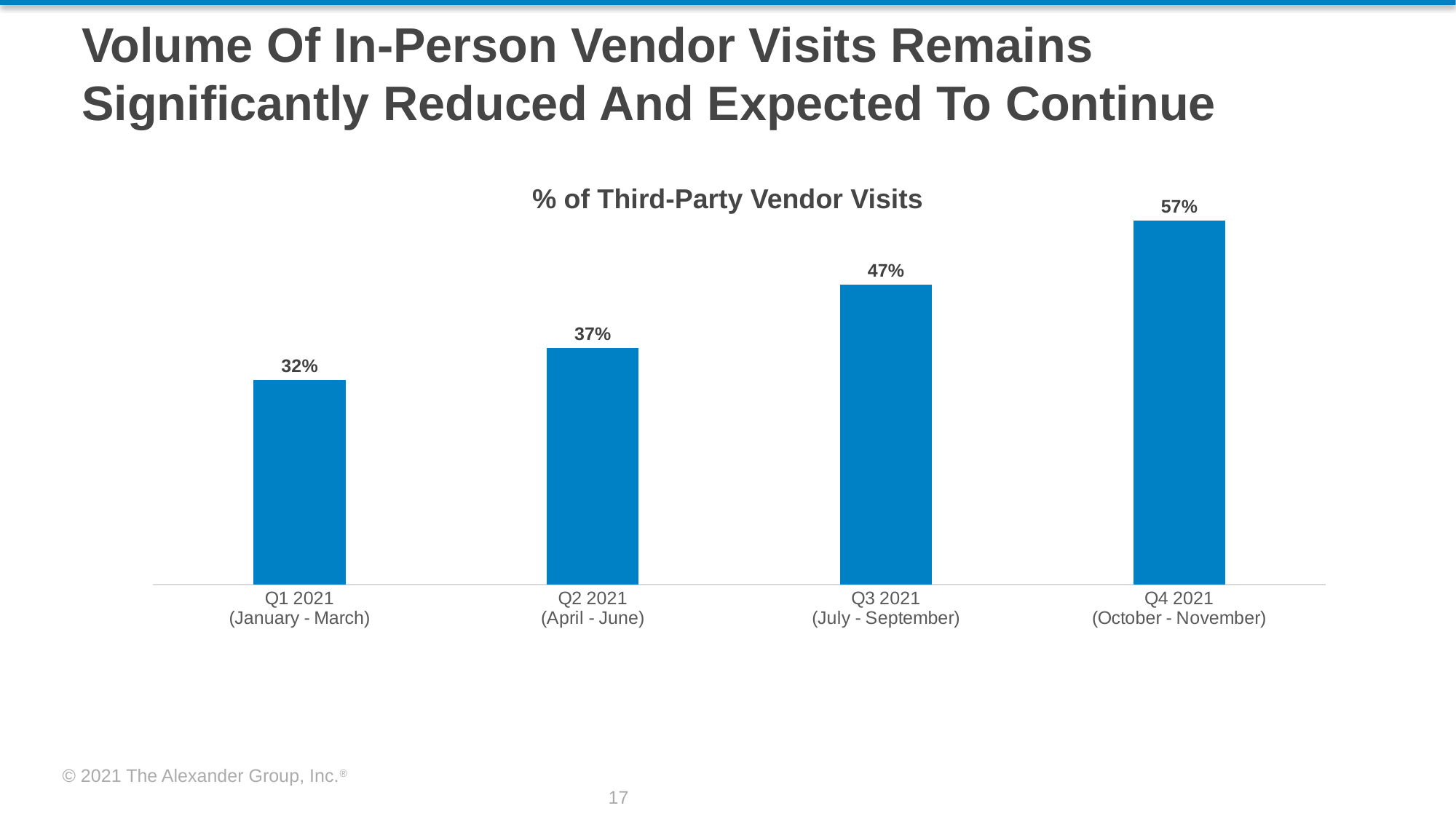
Which is larger, the value for Q2 2021 or the value for Q3 2021? Q3 2021 What is the difference between the values for Q4 2021 and Q1 2021? 25% Which quarter has the lowest % of third-party vendor visits? Q1 2021 (January - March) Do the values rise or fall from Q1 2021 to Q4 2021? Rise How many quarters are shown in the chart? 4 What is the value for Q2 2021 (April - June)? 37% What is the value for Q1 2021 (January - March)? 32% What is the value for Q4 2021 (October - November)? 57% Which quarter has the highest % of third-party vendor visits? Q4 2021 (October - November) What is the value for Q3 2021 (July - September)? 47% What kind of chart is shown on the slide? Bar chart What is the difference between the values for Q3 2021 and Q2 2021? 10%